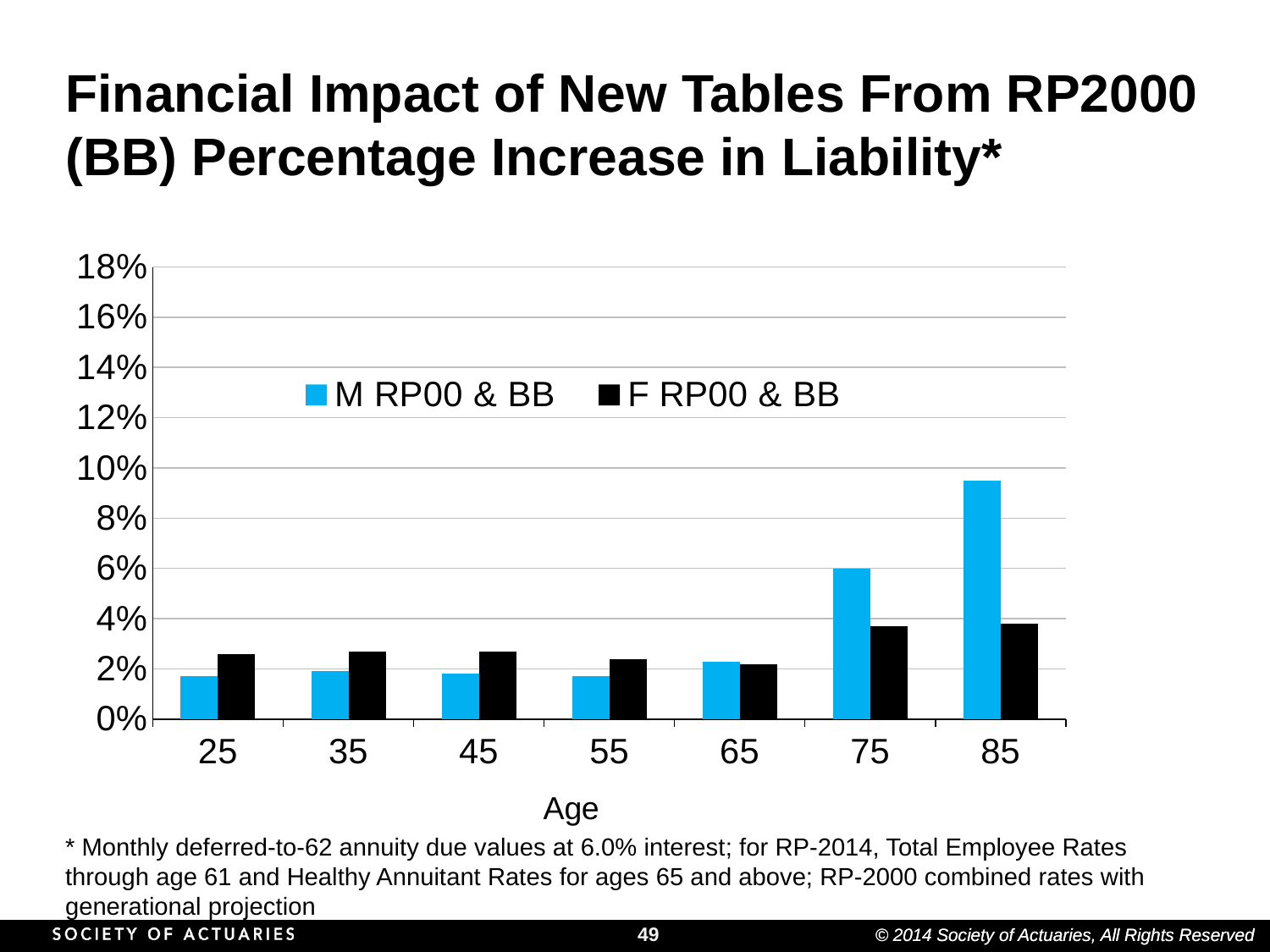
How many series does the legend list? 2 At age 85, which series has the larger value, M RP00 & BB or F RP00 & BB? M RP00 & BB What kind of chart is shown on the slide? bar chart Is the M RP00 & BB value at age 85 greater or less than 8%? greater Is the M RP00 & BB value at age 75 greater or less than 4%? greater Is the F RP00 & BB value at age 25 greater or less than 4%? less What is the title of the x axis? Age At age 25, which series has the larger value, M RP00 & BB or F RP00 & BB? F RP00 & BB Do the M RP00 & BB values rise or fall from age 65 to age 85? rise How many age categories are shown on the x axis? 7 For which age is the M RP00 & BB value highest? 85